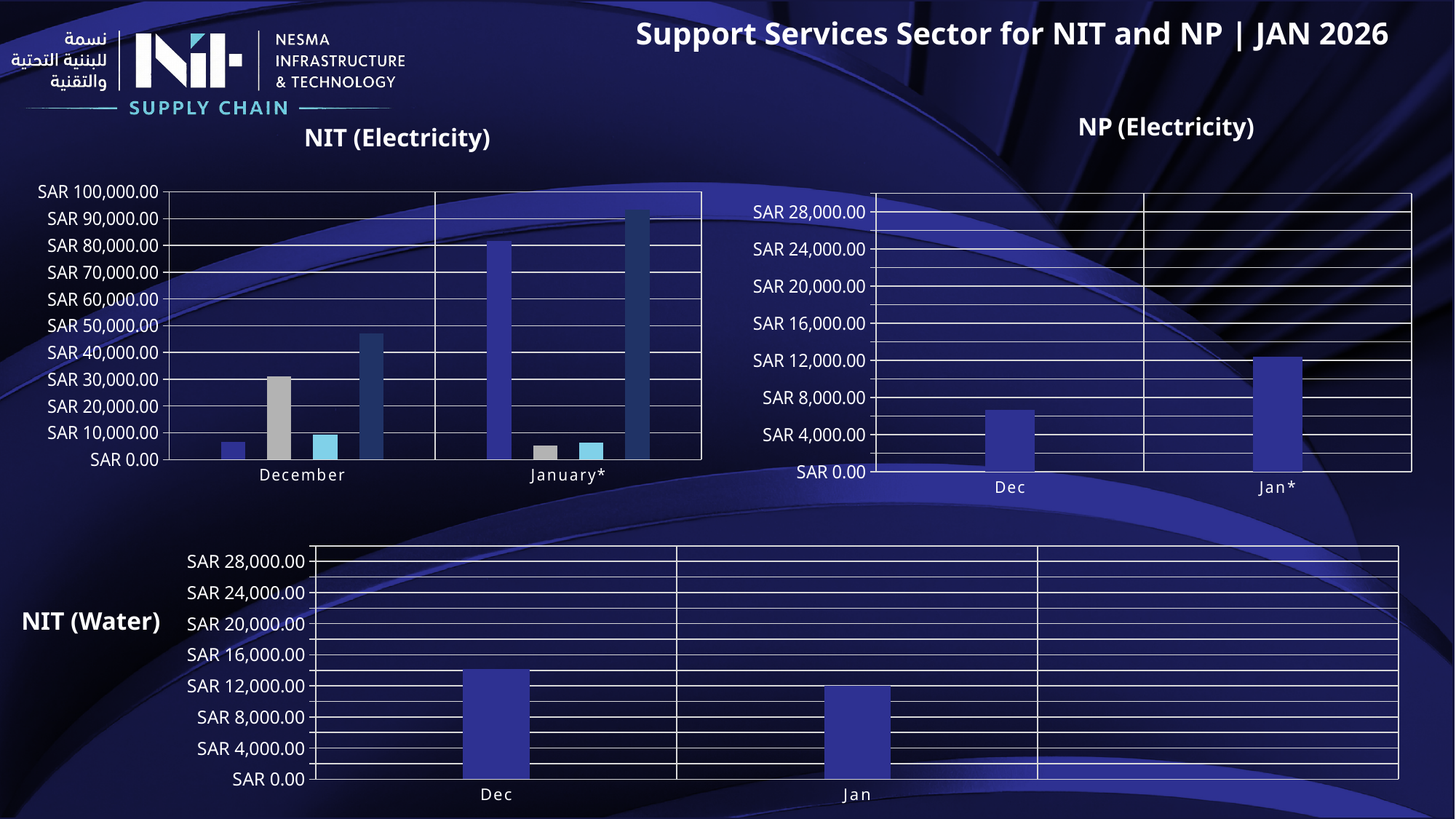
How many categories are shown on the x axis of the NIT (Water) chart? 2 In the NP (Electricity) chart, do the values rise or fall from Dec to Jan*? rise In the NIT (Water) chart, which month has the higher value, Dec or Jan? Dec In the NIT (Water) chart, is the value for Jan greater or less than SAR 16,000.00? less In the NP (Electricity) chart, is the value for Jan* greater or less than SAR 8,000.00? greater In the NP (Electricity) chart, which month has the higher value, Dec or Jan*? Jan* In the NIT (Water) chart, is the value for Dec greater or less than SAR 12,000.00? greater In the NIT (Water) chart, do the values rise or fall from Dec to Jan? fall What kind of chart is the NP (Electricity) chart? bar chart